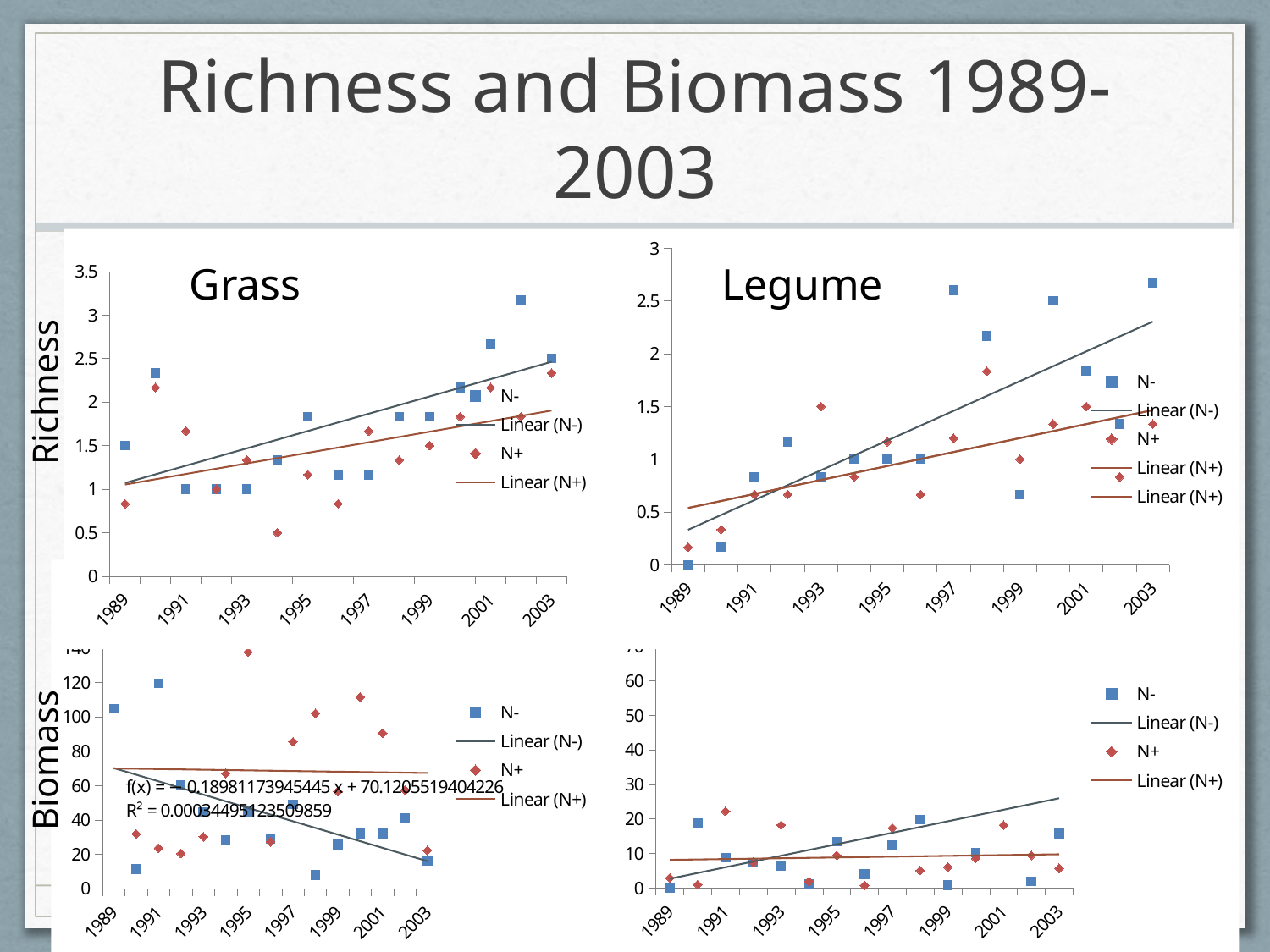
In the Legume Richness chart (top right), is the N- value for 2003 greater or less than 2.5? greater What is the title of the slide? Richness and Biomass 1989-2003 In the Grass Richness chart (top left), is the N+ value for 1994 greater or less than 1? less In the Legume Richness chart (top right), is the N+ value for 1989 greater or less than 0.5? less In the Grass Biomass chart (bottom left), does the Linear (N-) trend line rise or fall from 1989 to 2003? fall What kind of chart is the Grass Richness chart (top left)? scatter chart In the Legume Richness chart (top right), does the Linear (N+) trend line rise or fall across the years? rise In the Grass Richness chart (top left), does the Linear (N-) trend line rise or fall from 1989 to 2003? rise How many entries does the legend of the Grass Richness chart (top left) list? 4